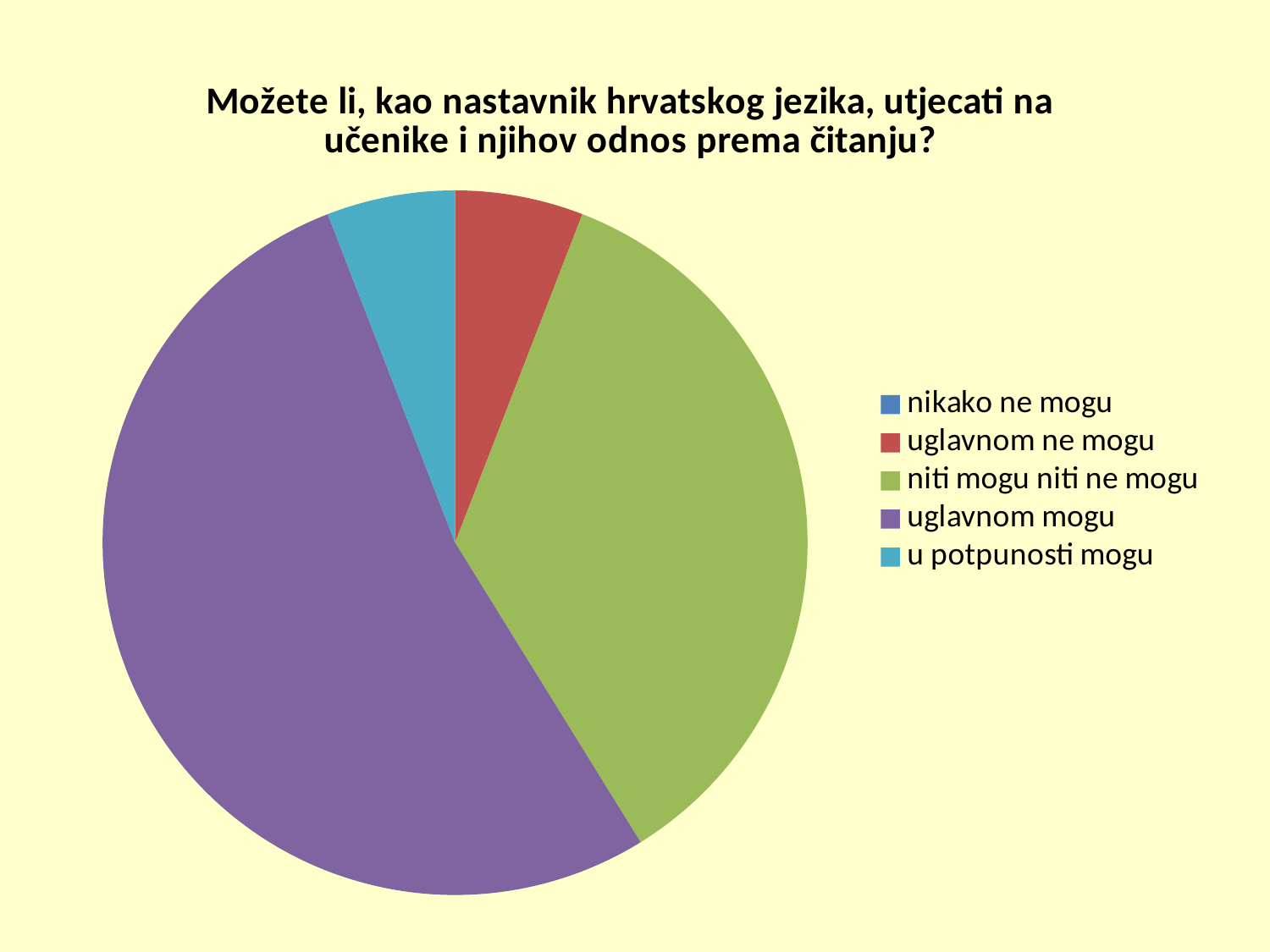
Which slice is larger: 'uglavnom mogu' or 'niti mogu niti ne mogu'? uglavnom mogu What is the title of the pie chart? Možete li, kao nastavnik hrvatskog jezika, utjecati na učenike i njihov odnos prema čitanju? Which legend entry is shown in purple? uglavnom mogu Which slice is larger: 'niti mogu niti ne mogu' or 'uglavnom ne mogu'? niti mogu niti ne mogu Which category has the second-largest slice of the pie chart? niti mogu niti ne mogu Which slice is larger: 'niti mogu niti ne mogu' or 'u potpunosti mogu'? niti mogu niti ne mogu Which category has the largest slice of the pie chart? uglavnom mogu How many slices are visible in the pie chart? 4 How many entries does the legend of the pie chart list? 5 What kind of chart is shown on the slide? pie chart